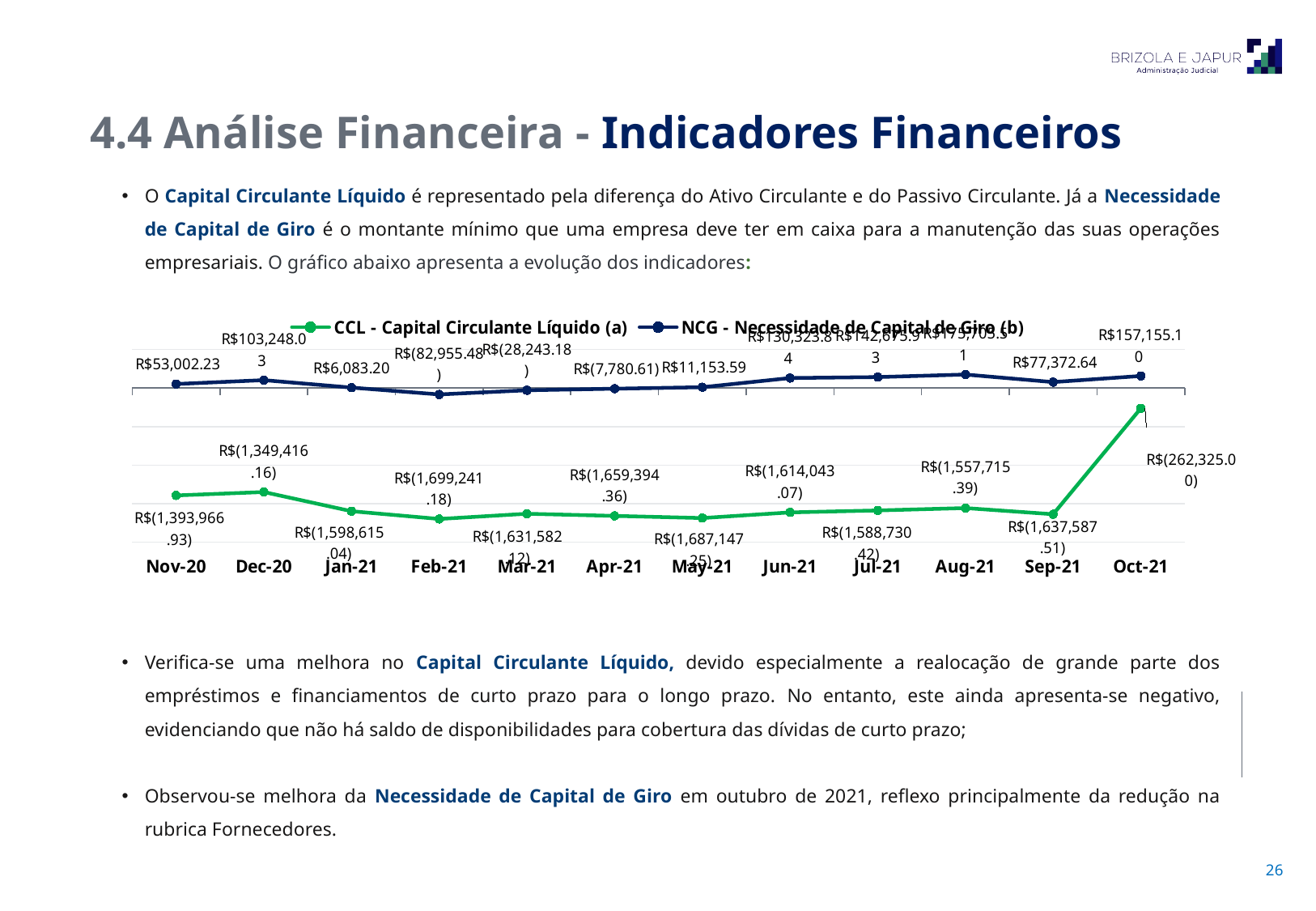
What is the value of CCL - Capital Circulante Líquido (a) for Feb-21? R$(1,699,241.18) Which is larger for NCG - Necessidade de Capital de Giro (b): Dec-20 or Jan-21? Dec-20 How many series does the legend list? 2 What colour is the line for CCL - Capital Circulante Líquido (a)? Green In which month is NCG - Necessidade de Capital de Giro (b) at its lowest? Feb-21 In which month is CCL - Capital Circulante Líquido (a) at its highest? Oct-21 What is the value of CCL - Capital Circulante Líquido (a) for Oct-21? R$(262,325.00) What kind of chart is shown on the slide? Line chart How many months are plotted along the x axis? 12 What is the value of NCG - Necessidade de Capital de Giro (b) for Nov-20? R$53,002.23 What is the difference between the NCG - Necessidade de Capital de Giro (b) values for Dec-20 and Nov-20? R$50,245.80 What is the value of NCG - Necessidade de Capital de Giro (b) for Sep-21? R$77,372.64